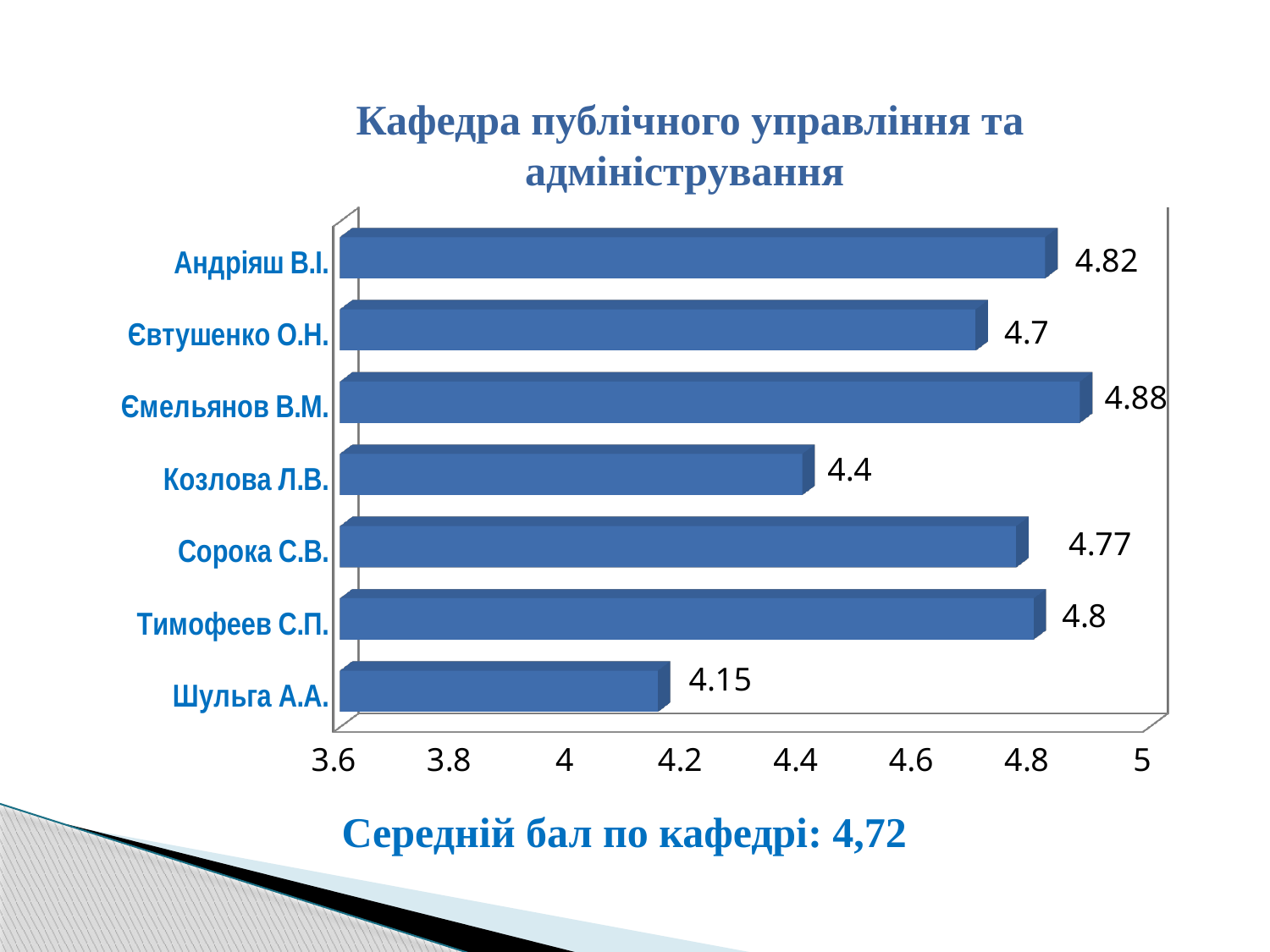
What kind of chart is shown on the slide? bar chart Which category has the highest value? Ємельянов В.М. What is the difference between the values for Ємельянов В.М. and Шульга А.А.? 0.73 What is the value for Козлова Л.В.? 4.4 What is the value for Сорока С.В.? 4.77 Which category has the lowest value? Шульга А.А. What is the title of the chart? Кафедра публічного управління та адміністрування How many categories are shown in the chart? 7 Is the value for Тимофеев С.П. greater or less than 4.6? greater Which is larger, the value for Євтушенко О.Н. or the value for Козлова Л.В.? Євтушенко О.Н. What is the value for Андріяш В.І.? 4.82 What is the value for Шульга А.А.? 4.15